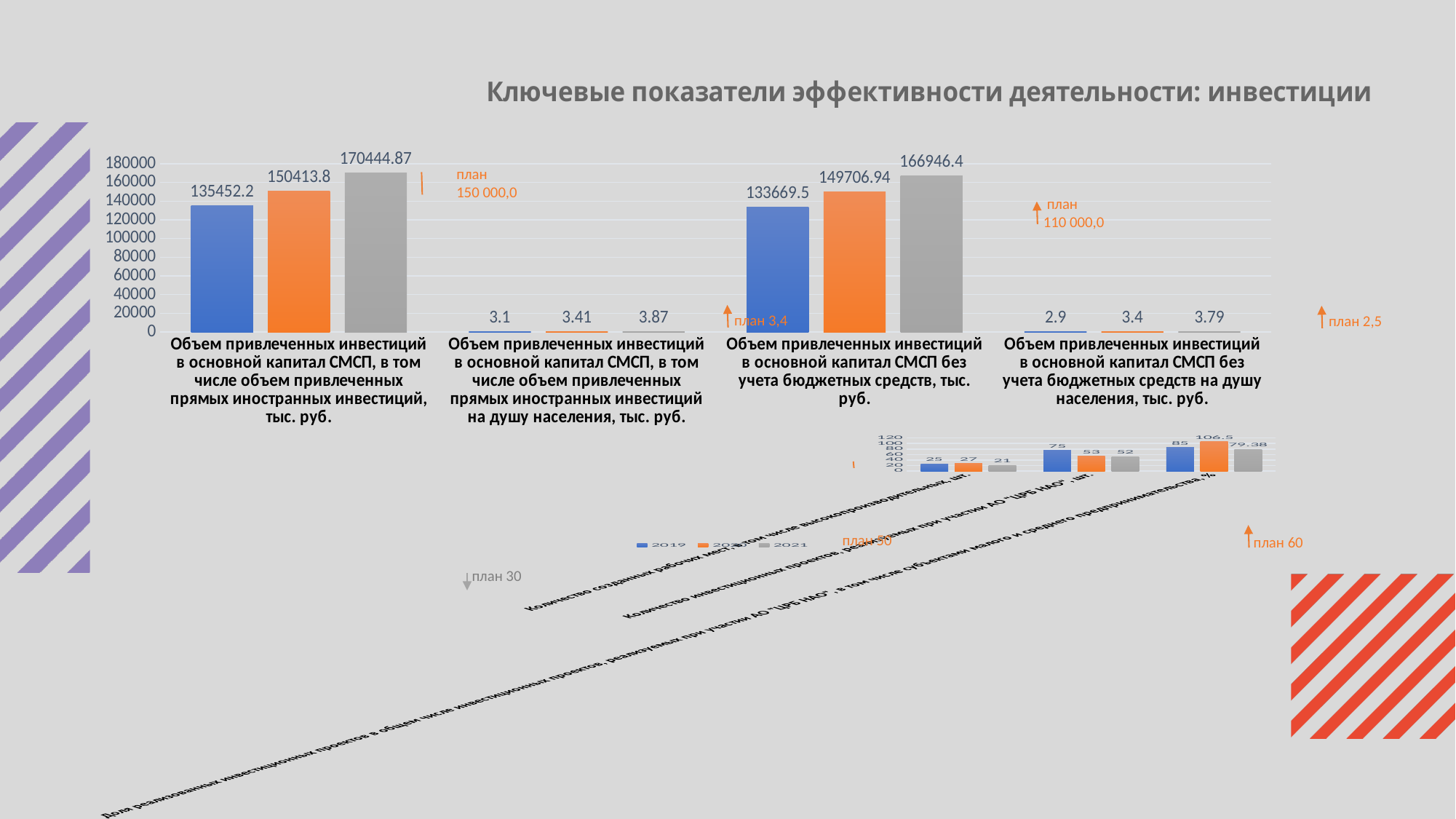
In the top chart, what is the value of the orange bar for 'Объем привлеченных инвестиций в основной капитал СМСП без учета бюджетных средств на душу населения, тыс. руб.'? 3.4 In the bottom chart, which year has the highest value for 'Доля реализованных инвестиционных проектов в общем числе инвестиционных проектов, реализуемых при участии АО "ЦРБ НАО", в том числе субъектам малого и среднего предпринимательства, %'? 2020 How many categories are shown on the x axis of the top chart? 4 In the top chart, do the values for 'Объем привлеченных инвестиций в основной капитал СМСП, в том числе объем привлеченных прямых иностранных инвестиций, тыс. руб.' rise or fall from the blue bar to the gray bar? rise In the top chart, what is the value of the gray bar for 'Объем привлеченных инвестиций в основной капитал СМСП, в том числе объем привлеченных прямых иностранных инвестиций, тыс. руб.'? 170444.87 In the top chart, which bar is the highest for 'Объем привлеченных инвестиций в основной капитал СМСП, в том числе объем привлеченных прямых иностранных инвестиций, тыс. руб.': blue, orange or gray? gray In the top chart, what is the value of the blue bar for 'Объем привлеченных инвестиций в основной капитал СМСП без учета бюджетных средств, тыс. руб.'? 133669.5 In the top chart, is the orange bar for 'Объем привлеченных инвестиций в основной капитал СМСП, в том числе объем привлеченных прямых иностранных инвестиций, тыс. руб.' greater or less than 140000? greater How many series does the legend of the bottom chart list? 3 What kind of chart is the top chart? bar chart In the top chart, what is the difference between the gray bar and the blue bar for 'Объем привлеченных инвестиций в основной капитал СМСП без учета бюджетных средств, тыс. руб.'? 33276.9 In the bottom chart, what is the value of the 2020 bar for 'Количество инвестиционных проектов, реализуемых при участии АО "ЦРБ НАО", шт.'? 53